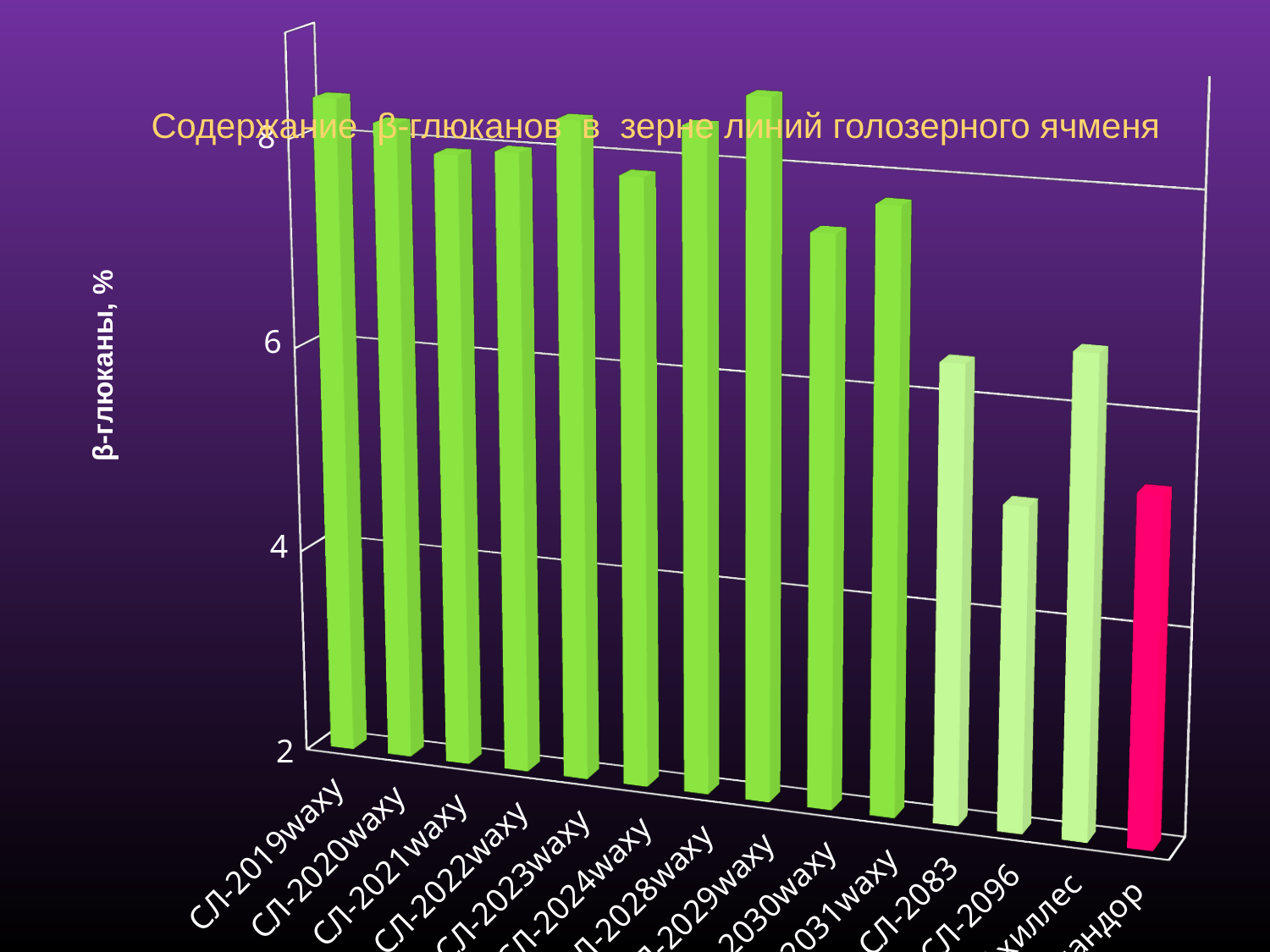
Which has the higher value, СЛ-2028waxy or СЛ-2030waxy? СЛ-2028waxy Is the value for СЛ-2096 greater or less than 6? less Which has the higher value, СЛ-2019waxy or СЛ-2096? СЛ-2019waxy Is the value for СЛ-2083 greater or less than 4? greater Is the value for СЛ-2024waxy greater or less than 6? greater What is the title of the chart? Содержание β-глюканов в зерне линий голозерного ячменя Which has the higher value, СЛ-2083 or СЛ-2096? СЛ-2083 How many bars (categories) are plotted in the chart? 14 What is the label of the vertical axis? β-глюканы, % What kind of chart is shown on the slide? Bar chart